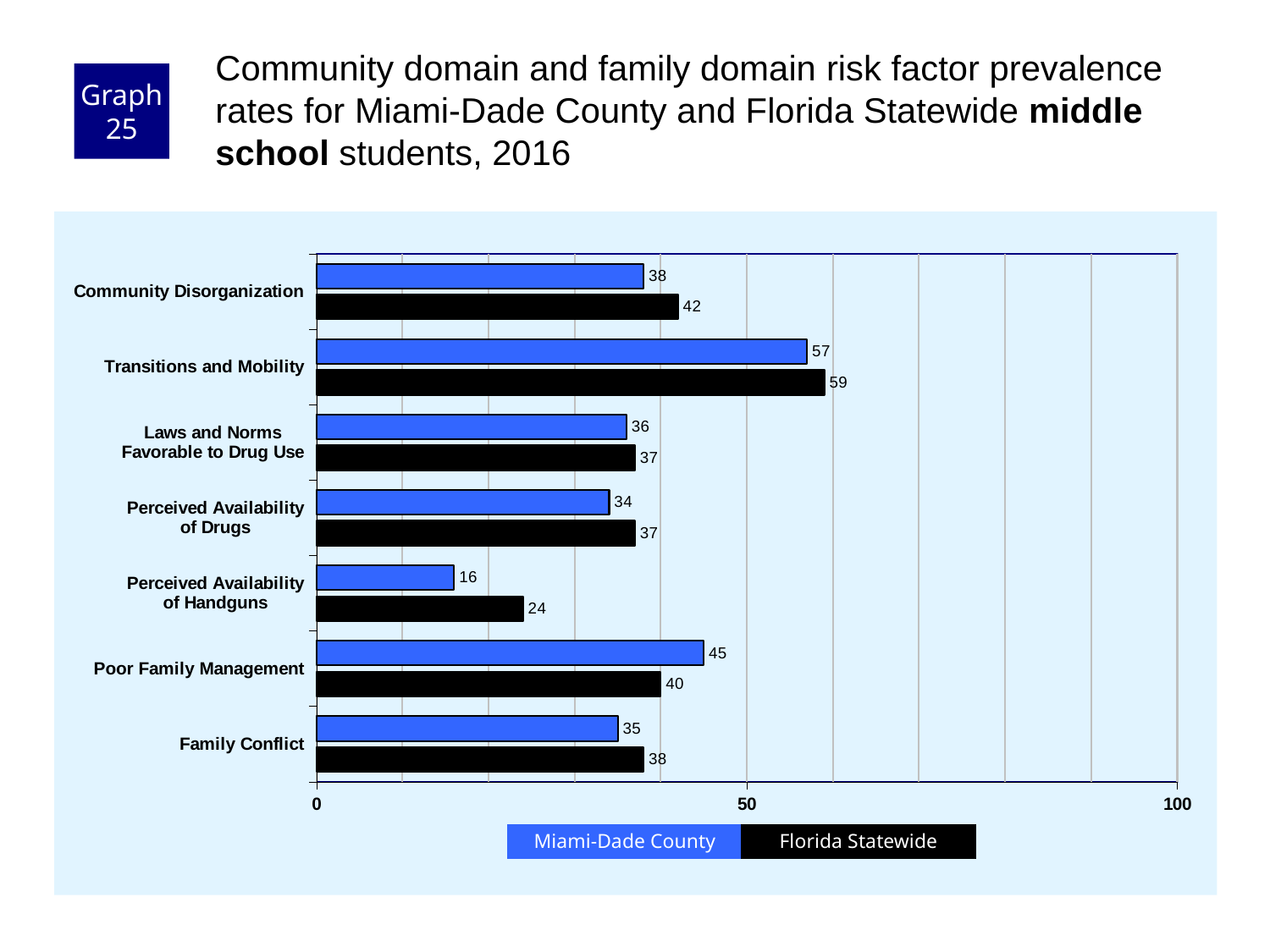
How many risk factor categories are shown on the chart? 7 Is the Florida Statewide value for Transitions and Mobility greater or less than 50? greater What is the Florida Statewide value for Perceived Availability of Handguns? 24 Which colour represents Florida Statewide in the chart? black For Poor Family Management, which is larger: the Miami-Dade County value or the Florida Statewide value? Miami-Dade County What kind of chart is shown on the slide? bar chart Which risk factor has the highest Florida Statewide value? Transitions and Mobility What is the Miami-Dade County value for Poor Family Management? 45 How many series does the legend list? 2 What is the difference between the Florida Statewide and Miami-Dade County values for Perceived Availability of Handguns? 8 What is the Miami-Dade County value for Transitions and Mobility? 57 Which risk factor has the lowest Miami-Dade County value? Perceived Availability of Handguns